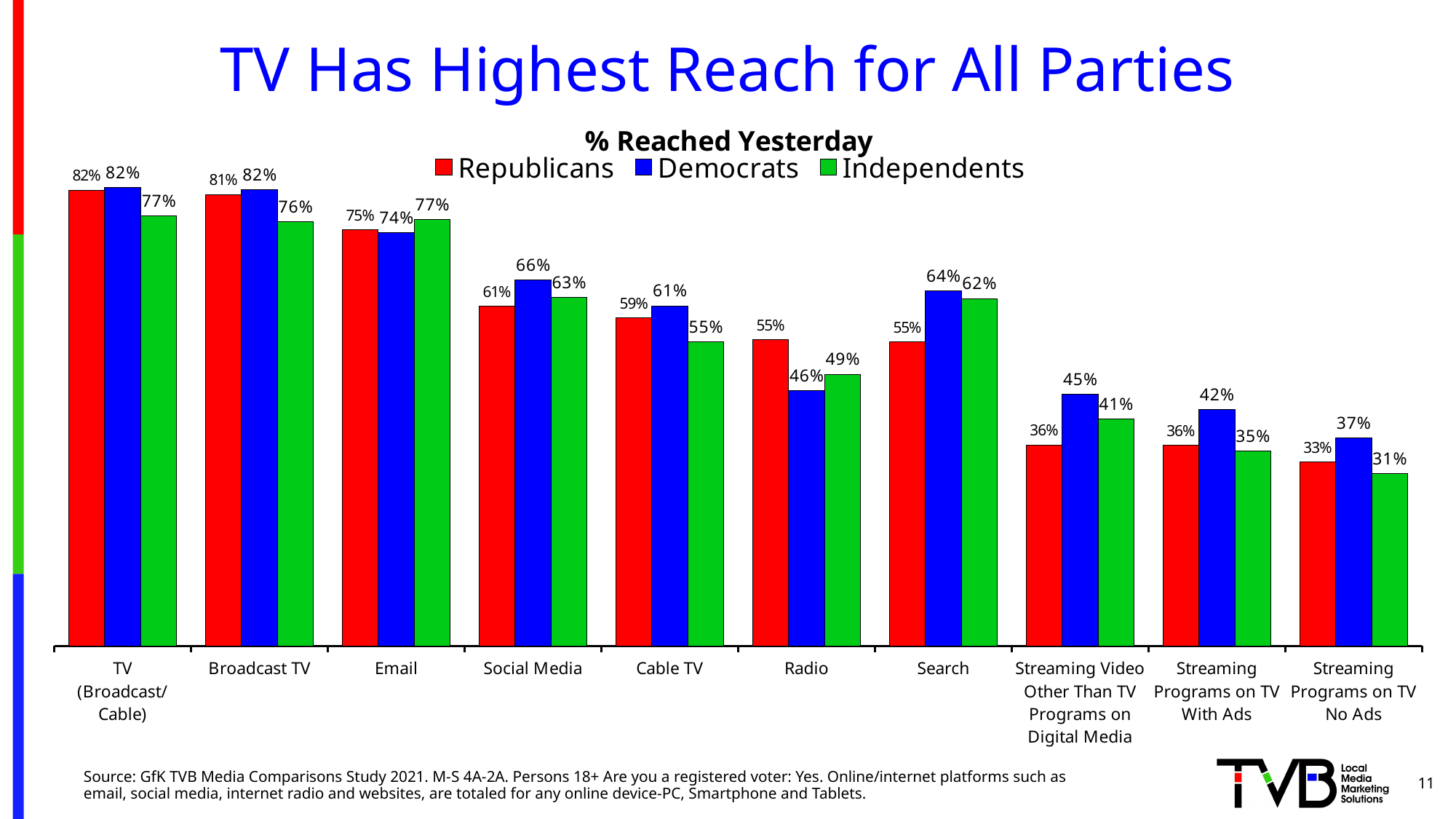
What is the value for Independents for Streaming Programs on TV No Ads? 31% For Radio, which is larger: the Republicans value or the Democrats value? Republicans How many series does the legend list? 3 What is the value for Republicans for Radio? 55% What kind of chart is shown on the slide? Bar chart Which colour represents Independents in the chart? Green What is the title of the chart? % Reached Yesterday What is the value for Democrats for Social Media? 66% What is the difference between the Democrats and Republicans values for Search? 9% Which category has the lowest value for Republicans? Streaming Programs on TV No Ads How many categories are shown on the x axis? 10